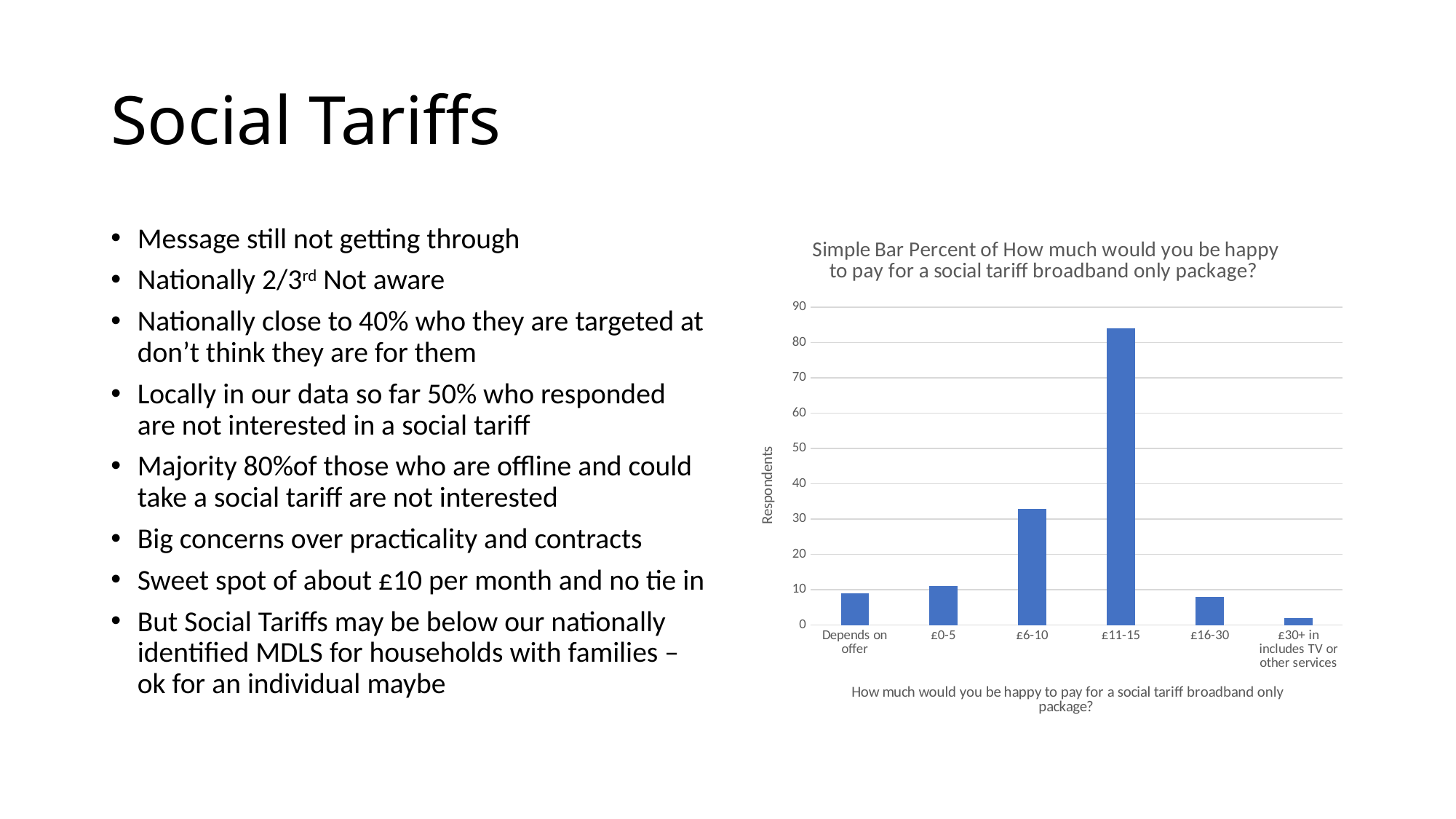
What kind of chart is shown on the slide? bar chart Is the value for £11-15 greater or less than 80? greater What is the label on the vertical axis of the chart? Respondents Which category has the highest number of respondents? £11-15 Which has more respondents, £6-10 or £0-5? £6-10 Is the value for £30+ in includes TV or other services greater or less than 10? less Is the value for £16-30 greater or less than 10? less Which category has the lowest number of respondents? £30+ in includes TV or other services Which has more respondents, £11-15 or £16-30? £11-15 How many categories are shown on the x axis of the chart? 6